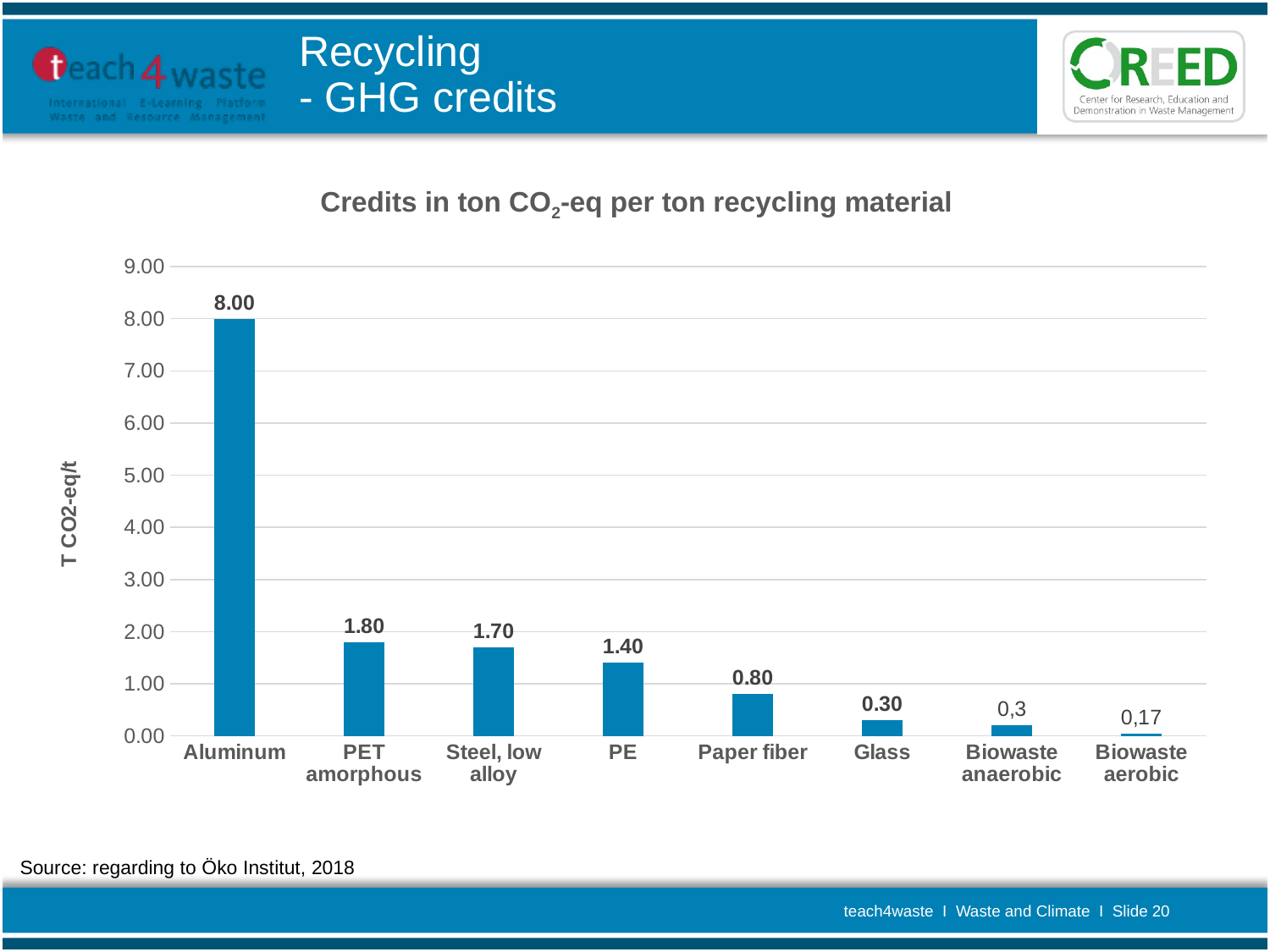
Which category has the lowest value? Biowaste aerobic What is the value for PET amorphous? 1.80 What is the value for Biowaste aerobic? 0,17 What is the difference between the values for Steel, low alloy and PE? 0.30 What kind of chart is this? Bar chart How many categories are shown on the x axis? 8 What is the value for Paper fiber? 0.80 Which is larger, the value for PE or the value for Paper fiber? PE What is the label of the y axis? T CO2-eq/t What is the difference between the values for Aluminum and PET amorphous? 6.20 What is the value for Aluminum? 8.00 Which category has the highest value? Aluminum